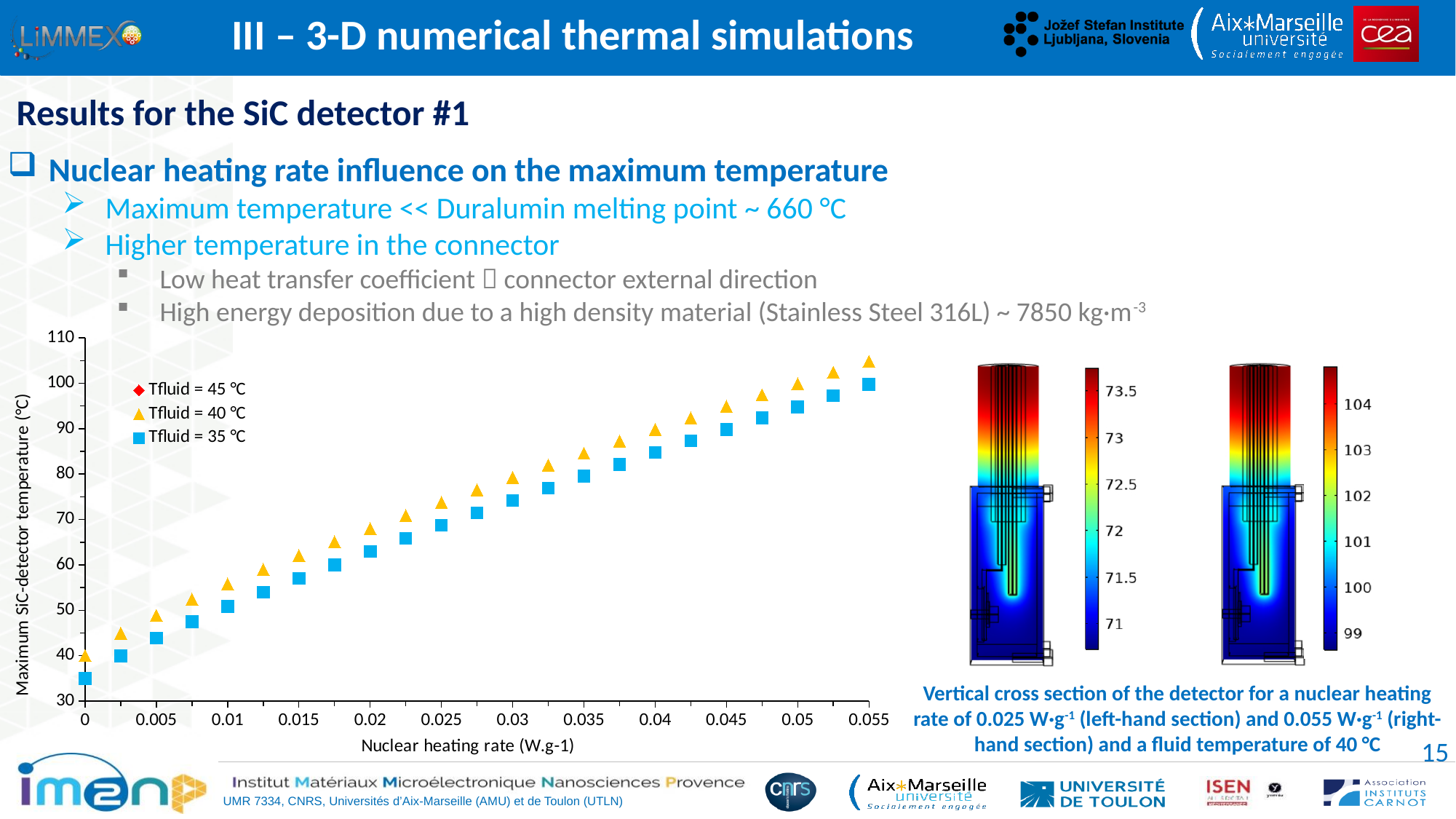
Is the value for Tfluid = 40 °C at a nuclear heating rate of 0.025 greater or less than 70? greater Do the values for the Tfluid = 35 °C series rise or fall as the nuclear heating rate increases? rise Is the value for Tfluid = 35 °C at a nuclear heating rate of 0 greater or less than 40? less What is the label of the x axis of the chart? Nuclear heating rate (W.g-1) Which series does the legend list first? Tfluid = 45 °C At a nuclear heating rate of 0.055, which series has the higher maximum temperature, Tfluid = 40 °C or Tfluid = 35 °C? Tfluid = 40 °C Which series contains the lowest plotted point on the chart? Tfluid = 35 °C Is the value for Tfluid = 40 °C at a nuclear heating rate of 0.055 greater or less than 100? greater How many series does the chart legend list? 3 Which series contains the highest plotted point on the chart? Tfluid = 40 °C What kind of chart is shown on the slide? scatter chart